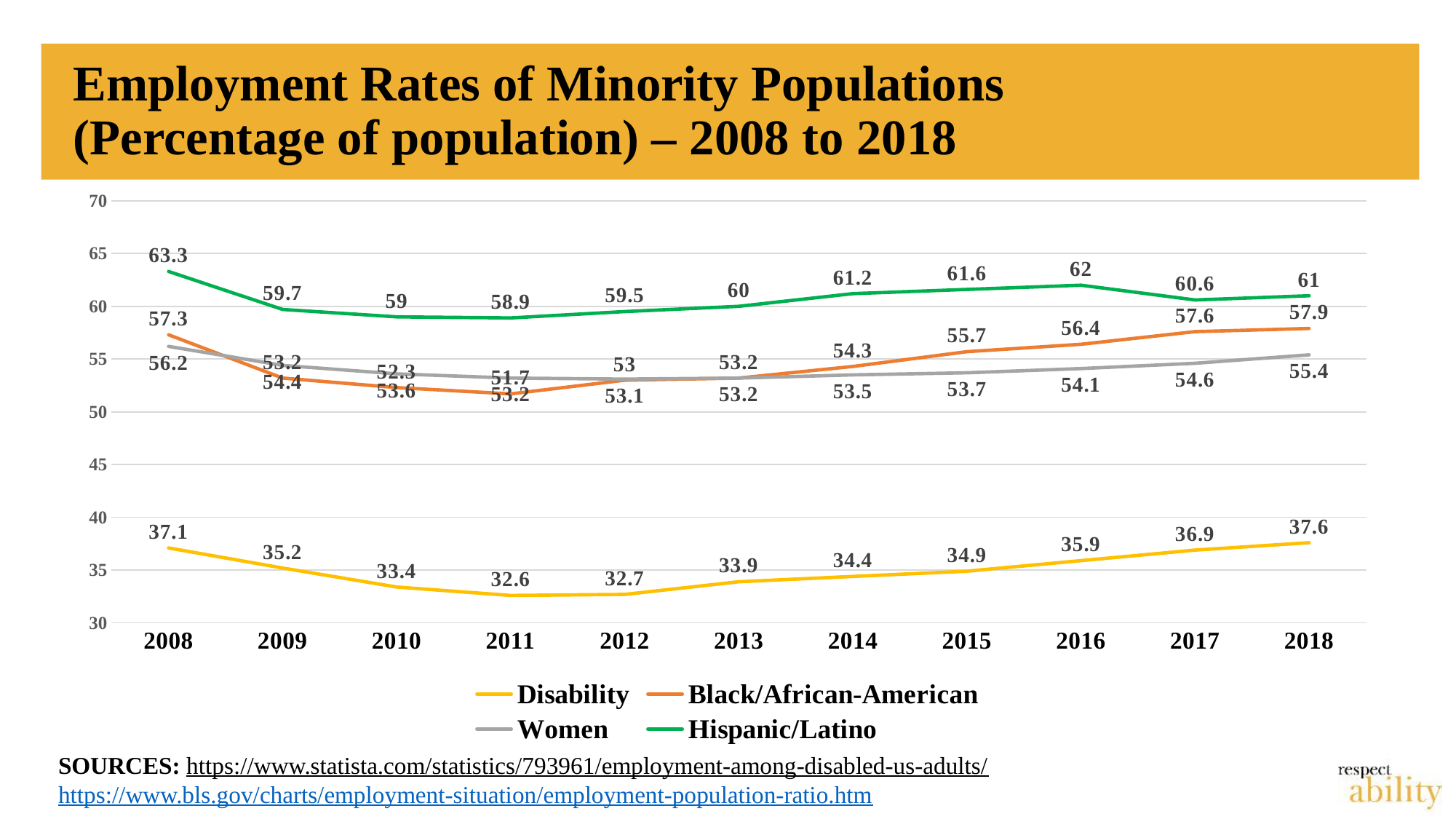
In which year is the Hispanic/Latino employment rate highest? 2008 Which series has the higher value in 2015, Black/African-American or Women? Black/African-American What is the employment rate for the Disability series in 2011? 32.6 What is the difference between the Hispanic/Latino rate and the Disability rate in 2018? 23.4 What type of chart is shown on the slide? line chart How many series does the legend list? 4 In which year is the Disability employment rate lowest? 2011 What is the employment rate for Women in 2008? 56.2 How does the Disability employment rate change from 2011 to 2018? It rises How many years are plotted along the x axis? 11 What is the employment rate for Black/African-American in 2018? 57.9 What is the employment rate for Hispanic/Latino in 2016? 62